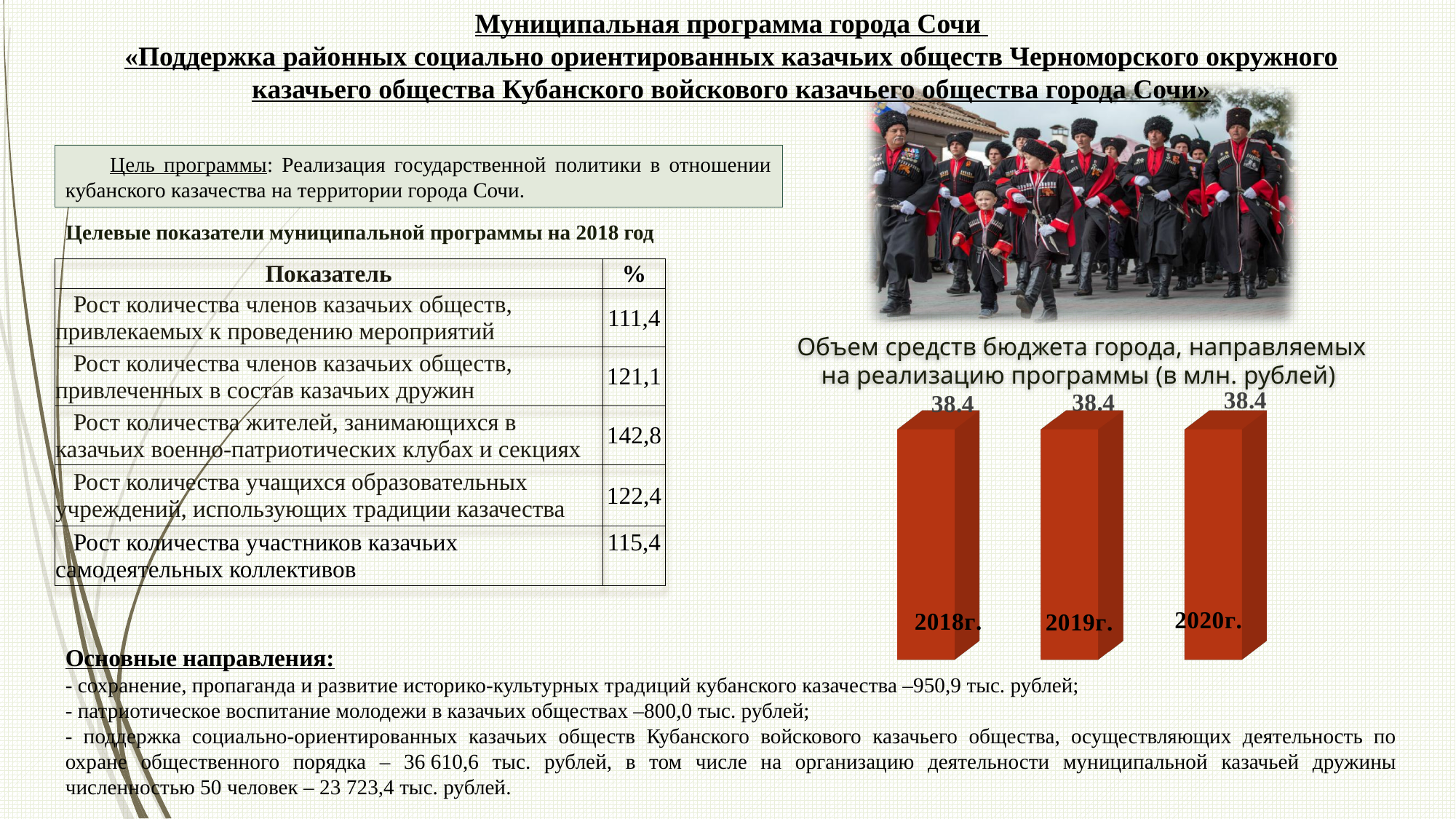
What is the value for 2019 in the chart? 38.4 Do the values rise, fall or stay the same from 2018 to 2020? Stay the same What is the value for 2018 in the chart? 38.4 What is the difference between the values for 2018 and 2020? 0 What kind of chart is shown on the slide? Bar chart In what units are the chart values given, according to the chart title? млн. рублей What is the value for 2020 in the chart? 38.4 What colour are the bars in the chart? Red (dark orange-red) How many bars (years) are shown in the chart? 3 Which years are shown on the x axis of the chart? 2018г., 2019г., 2020г. Are the values for 2018 and 2019 equal? Yes